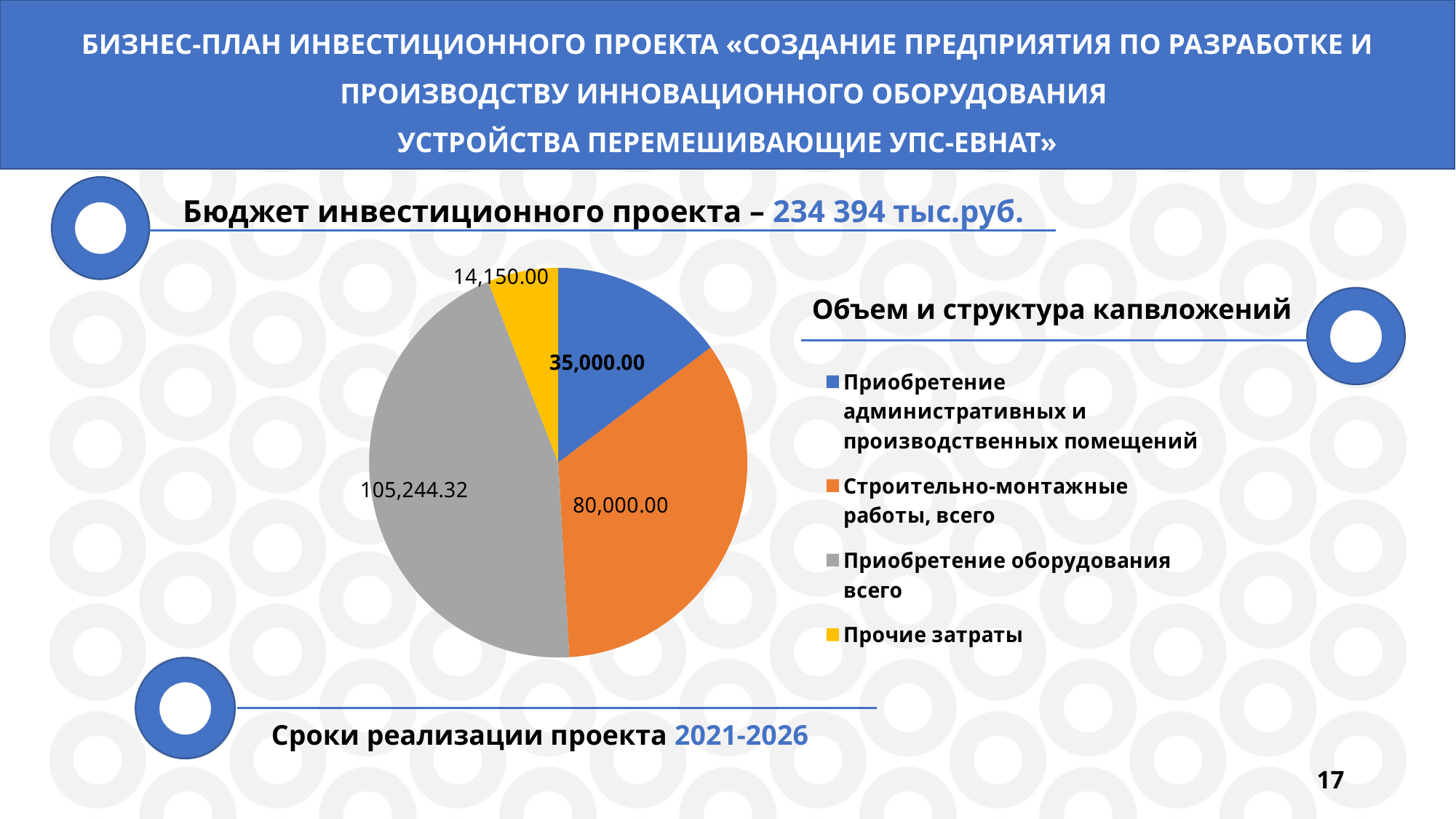
How many slices does the pie chart have? 4 What is the value for «Приобретение оборудования всего» in the pie chart? 105,244.32 What is the title of the pie chart? Объем и структура капвложений What is the total of all slices in the pie chart? 234,394.32 What is the value for «Приобретение административных и производственных помещений» in the pie chart? 35,000.00 Which is larger: «Строительно-монтажные работы, всего» or «Приобретение административных и производственных помещений»? Строительно-монтажные работы, всего What is the value for «Прочие затраты» in the pie chart? 14,150.00 What is the difference between «Приобретение оборудования всего» and «Строительно-монтажные работы, всего»? 25,244.32 Which category has the smallest slice in the pie chart? Прочие затраты What kind of chart is shown on the slide? Pie chart Which category has the largest slice in the pie chart? Приобретение оборудования всего What is the value for «Строительно-монтажные работы, всего» in the pie chart? 80,000.00